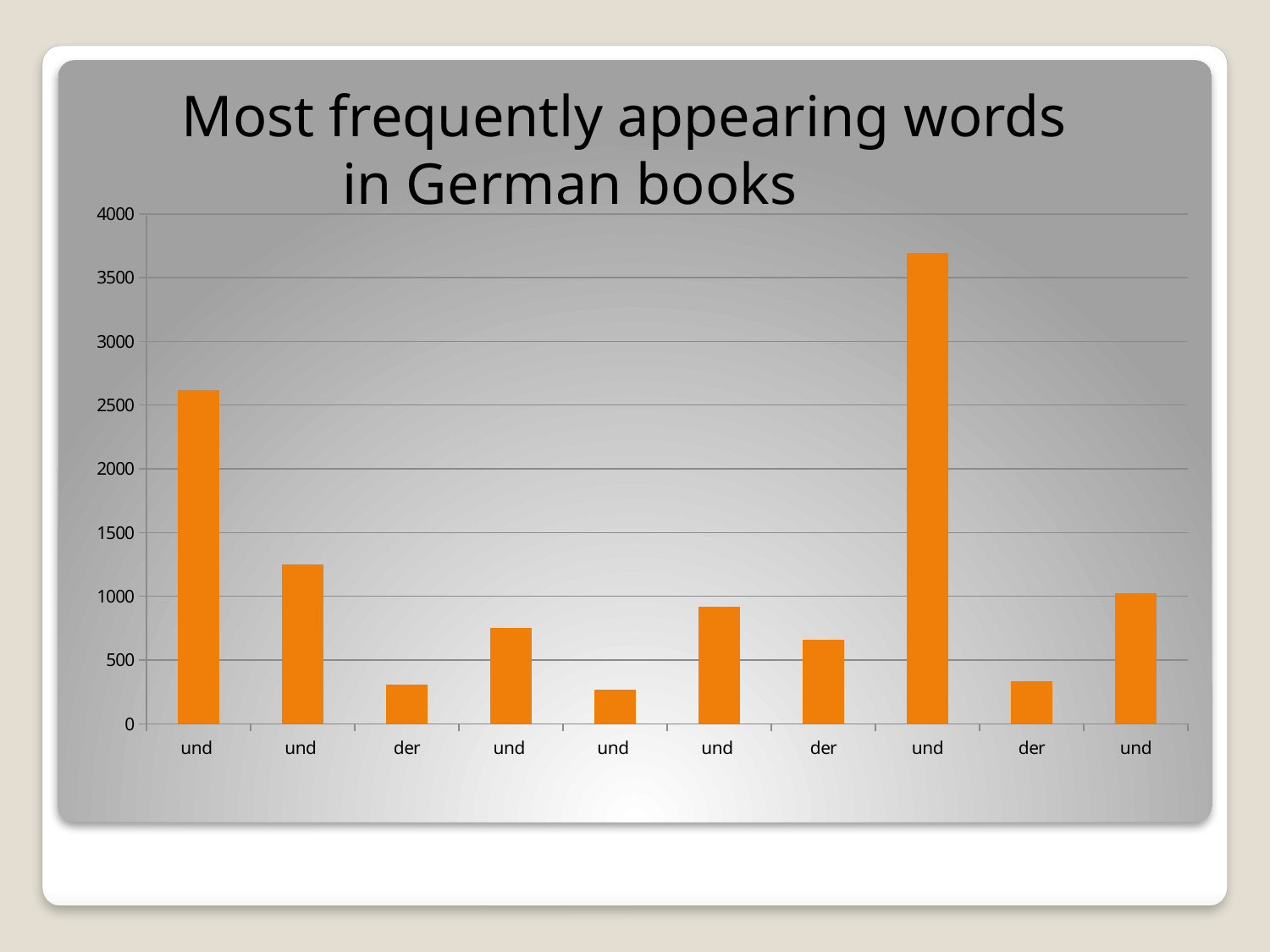
Is the value of the eighth bar (und) greater or less than 3500? greater Which is taller, the first bar or the second bar? the first bar Is the value of the tenth bar (und) greater or less than 1500? less What is the title of the chart? Most frequently appearing words in German books Is the value of the second bar (und) greater or less than 1000? greater Which is taller, the sixth bar (und) or the seventh bar (der)? the sixth bar (und) How many bars are plotted in the chart? 10 What is the highest value shown on the vertical axis? 4000 Which bar is the tallest in the chart? the eighth bar (und) What kind of chart is shown on the slide? bar chart